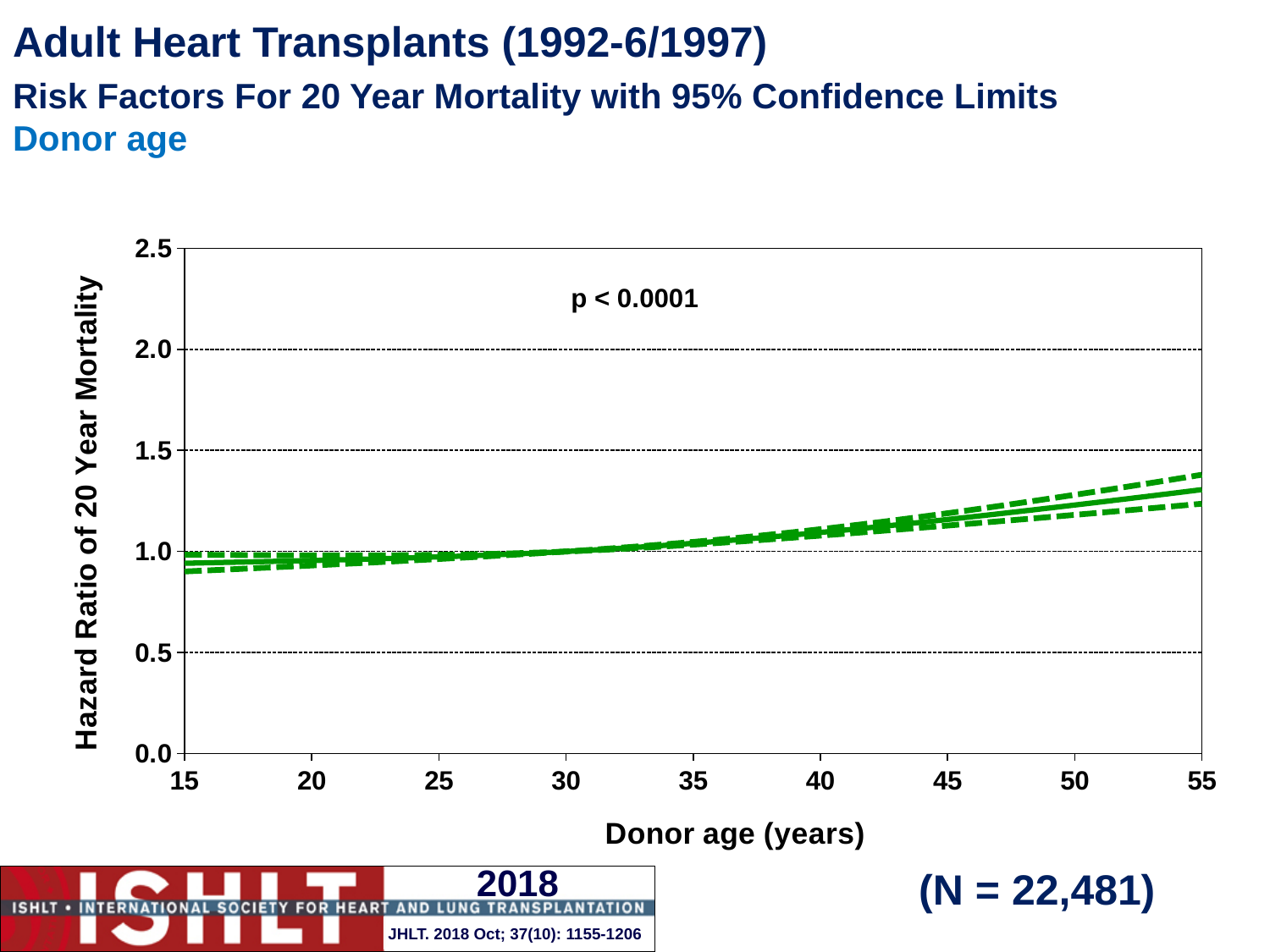
What p-value is printed on the chart? p < 0.0001 Is the hazard ratio at donor age 50 greater or less than 2.0? less Is the hazard ratio at donor age 55 greater or less than 1.0? greater Which has the larger hazard ratio, donor age 15 or donor age 55? donor age 55 Is the hazard ratio at donor age 45 greater or less than 1.5? less What sample size (N) is shown on the slide? N = 22,481 How does the hazard ratio of 20 year mortality change as donor age increases from 15 to 55 years? It rises At which donor age shown on the x axis is the hazard ratio lowest? 15 At which donor age shown on the x axis is the hazard ratio highest? 55 What kind of chart is shown on the slide? line chart